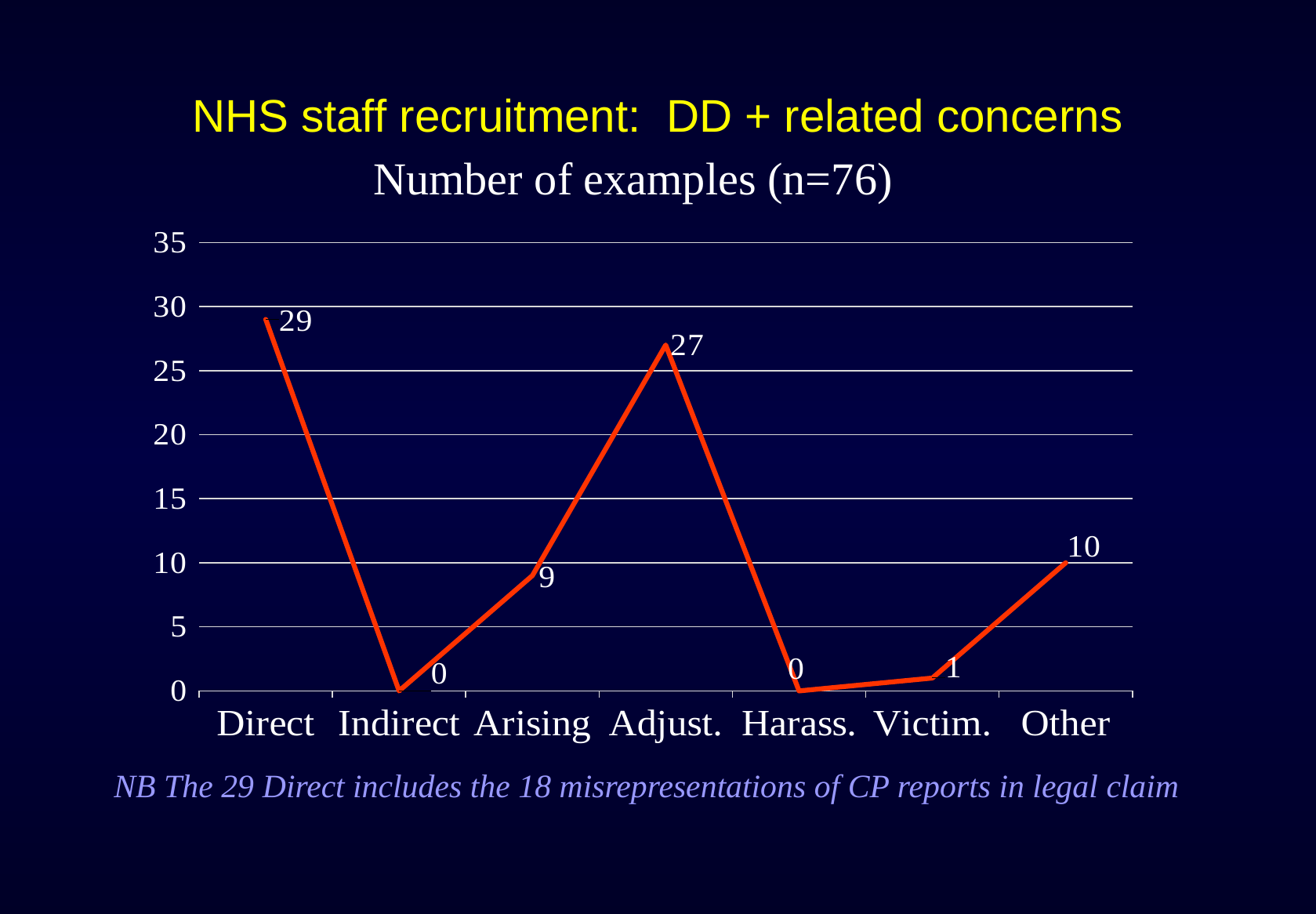
What is the difference between the values for Direct and Adjust.? 2 Which category has the highest number of examples? Direct Which is larger, the value for Victim. or the value for Other? Other What is the difference between the values for Other and Arising? 1 How many categories are shown on the x axis? 7 What is the number of examples for Adjust.? 27 What is the number of examples for Direct? 29 Which two categories have a value of 0? Indirect and Harass. What is the chart's title? Number of examples (n=76) What is the number of examples for Other? 10 What is the number of examples for Arising? 9 What kind of chart is shown on the slide? Line chart